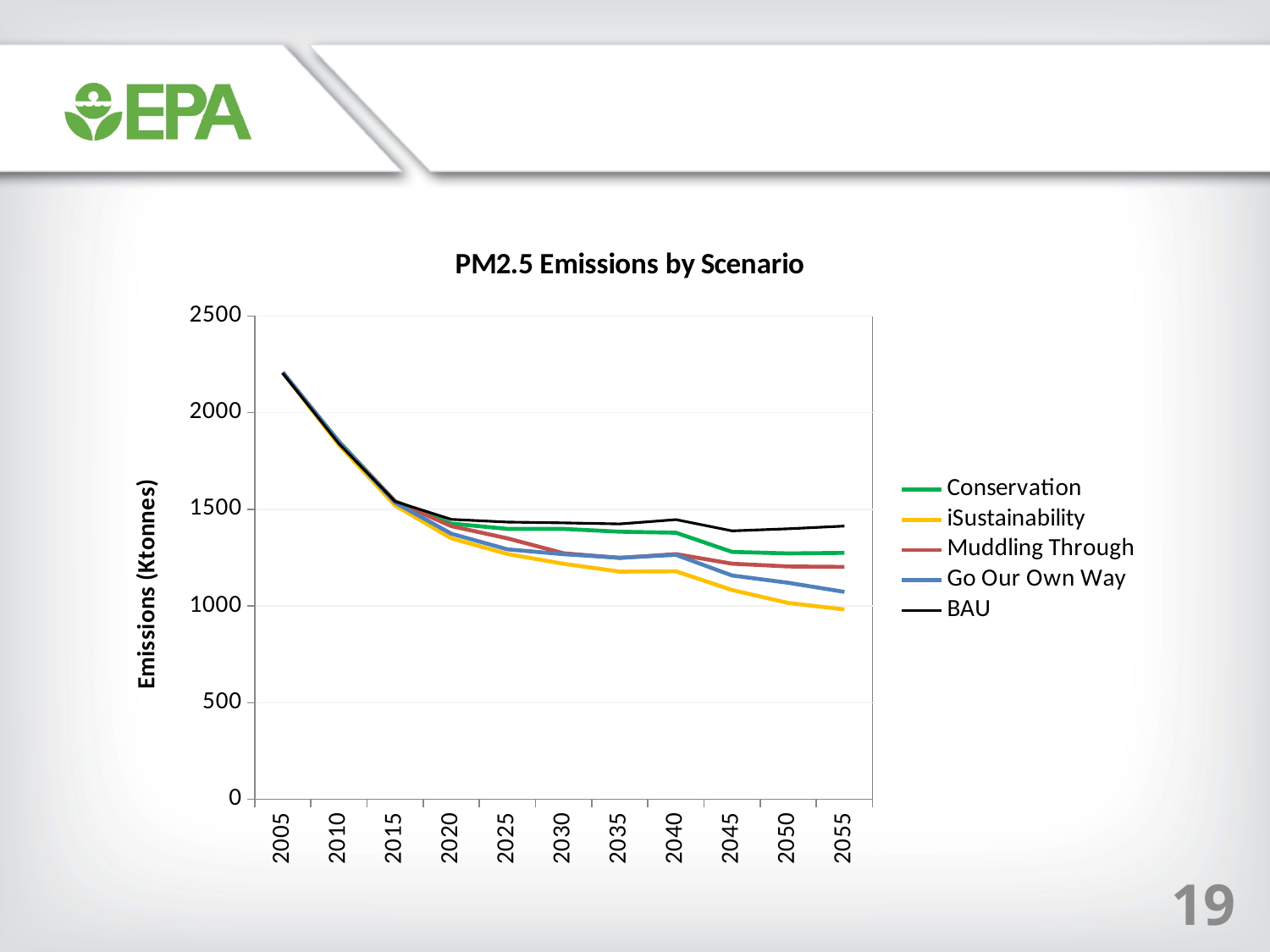
Is the value for BAU in 2005 greater or less than 2000? greater What is the label on the y axis? Emissions (Ktonnes) What is the title of the chart? PM2.5 Emissions by Scenario What kind of chart is shown on the slide? line chart Do the emissions values generally rise or fall from 2005 to 2055? fall In 2055, which is larger: Conservation or Muddling Through? Conservation Which scenario has the highest emissions in 2055? BAU Is the value for Go Our Own Way in 2055 greater or less than 1500? less Is the value for Conservation in 2055 greater or less than 1000? greater How many series does the legend list? 5 Which scenario has the lowest emissions in 2055? iSustainability How many years are marked along the x axis? 11